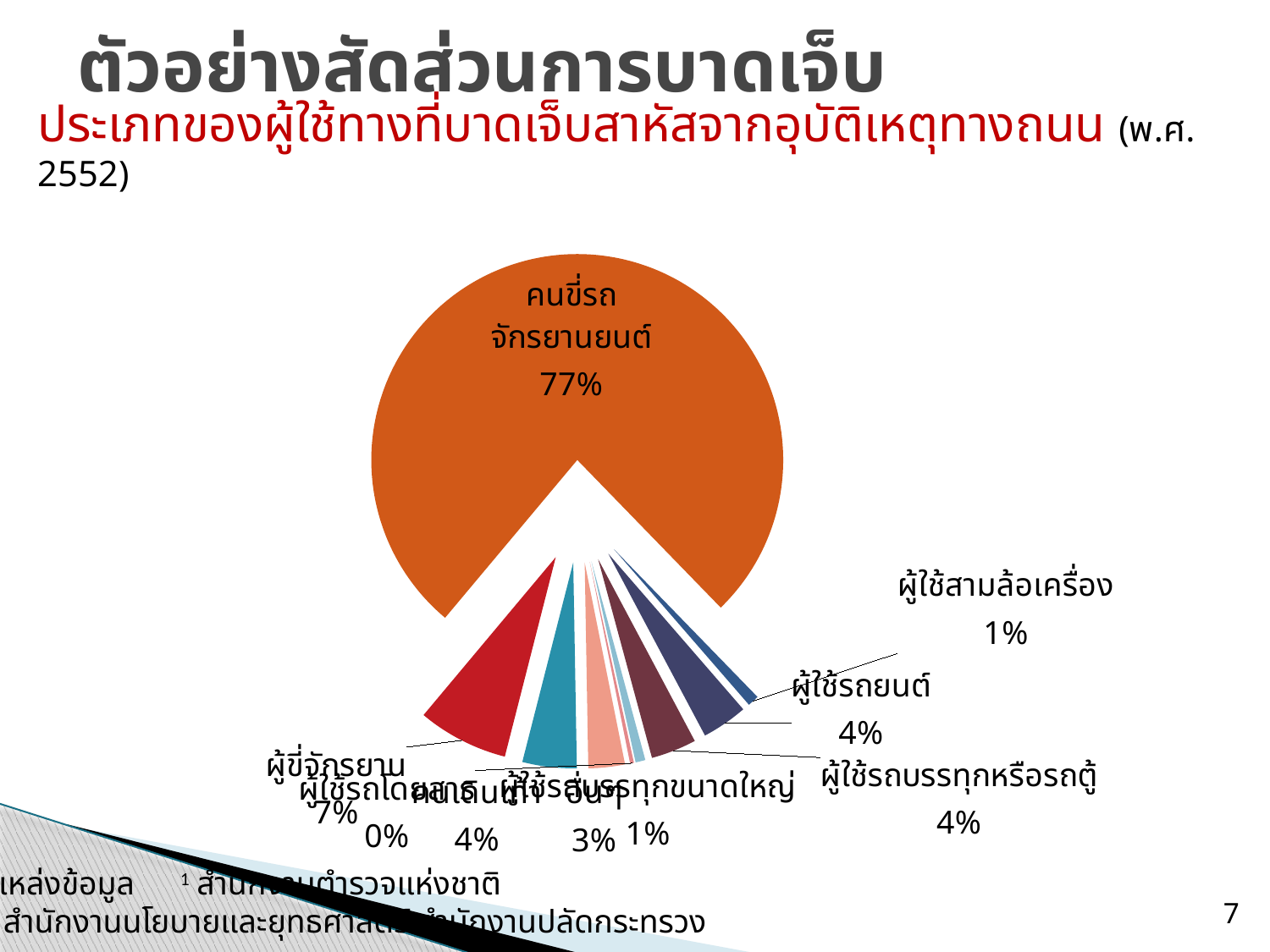
What kind of chart is shown on the slide? Pie chart What share of the pie is labelled for คนขี่รถจักรยานยนต์? 77% Which category has the largest slice of the pie? คนขี่รถจักรยานยนต์ What colour is the largest slice of the pie? Orange Which category has the smallest share of the pie? ผู้ใช้รถโดยสาร What percentage is shown for คนเดินเท้า? 4% What percentage is shown for ผู้ใช้สามล้อเครื่อง? 1% What percentage is shown for ผู้ใช้รถยนต์? 4% How many percentage points larger is the share for คนขี่รถจักรยานยนต์ than for ผู้ขี่จักรยาน? 70 percentage points What percentage is shown for ผู้ขี่จักรยาน? 7% Which has the larger share, ผู้ขี่จักรยาน or ผู้ใช้รถยนต์? ผู้ขี่จักรยาน What percentage is shown for ผู้ใช้รถโดยสาร? 0%